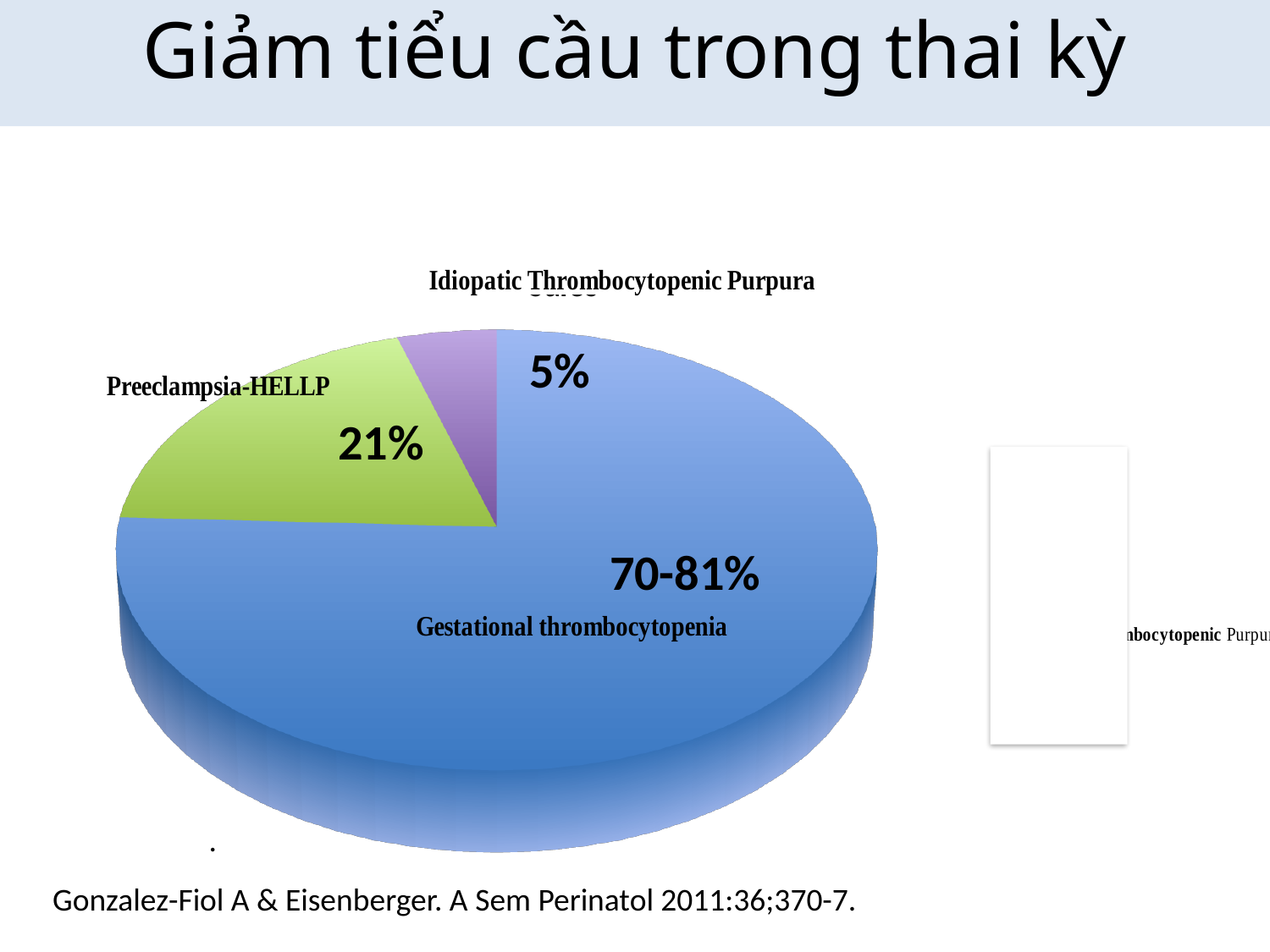
Which slice is larger, Preeclampsia-HELLP or Idiopatic Thrombocytopenic Purpura? Preeclampsia-HELLP What share of the pie is labelled for Gestational thrombocytopenia? 70-81% Which category has the largest slice of the pie? Gestational thrombocytopenia Which category has the smallest slice of the pie? Idiopatic Thrombocytopenic Purpura What colour is the Preeclampsia-HELLP slice? green What share of the pie is labelled for Idiopatic Thrombocytopenic Purpura? 5% How many slices does the pie chart have? 3 What colour is the Gestational thrombocytopenia slice? blue What share of the pie is labelled for Preeclampsia-HELLP? 21% What type of chart is shown on the slide? pie chart What is the difference in percentage points between the Preeclampsia-HELLP slice and the Idiopatic Thrombocytopenic Purpura slice? 16%